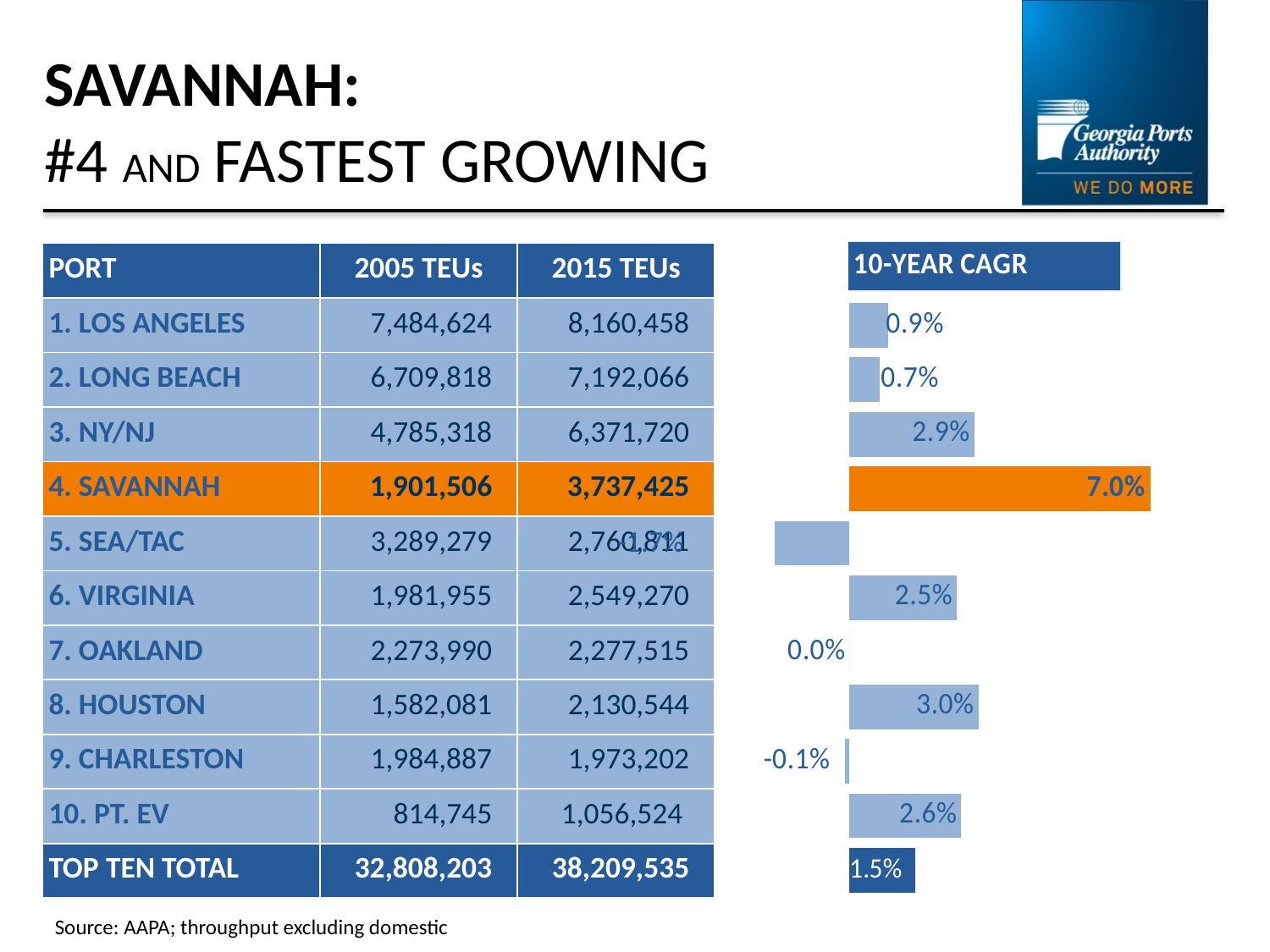
What is the title of the chart on the right of the slide? 10-YEAR CAGR Which port has the highest 10-year CAGR in the chart? Savannah What is the 10-year CAGR shown for Charleston? -0.1% What is the 10-year CAGR shown for Houston? 3.0% What kind of chart is used to show the 10-year CAGR? Bar chart What is the 10-year CAGR shown for the Top Ten Total? 1.5% Which port has the lowest 10-year CAGR in the chart? SEA/TAC What is the 10-year CAGR shown for Savannah? 7.0% What is the difference between the 10-year CAGR of Savannah and NY/NJ? 4.1 percentage points Which has a higher 10-year CAGR, Los Angeles or Long Beach? Los Angeles Which has a higher 10-year CAGR, Virginia or Pt. EV? Pt. EV How many ports have a negative 10-year CAGR in the chart? 2